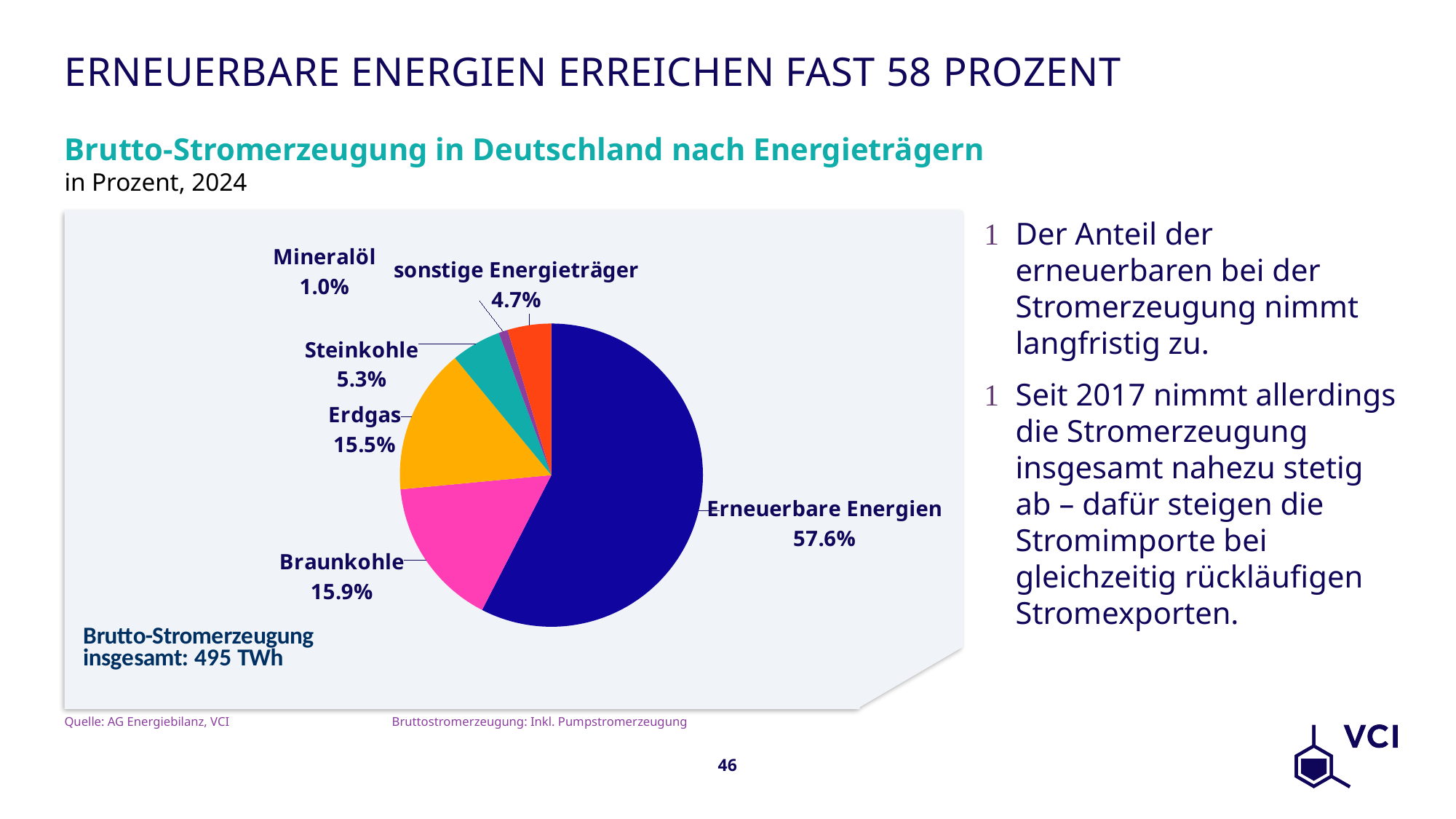
What is the difference in percentage points between Braunkohle and Erdgas? 0.4 What is the share shown for Steinkohle? 5.3% What is the share shown for sonstige Energieträger? 4.7% What share of gross electricity generation does Erneuerbare Energien have in the pie chart? 57.6% What type of chart is shown on the slide? Pie chart What is the share shown for Braunkohle? 15.9% What total gross electricity generation in TWh is stated on the chart? 495 TWh Which energy source has the smallest slice of the pie? Mineralöl How many energy source categories are shown in the pie chart? 6 What is the share shown for Erdgas? 15.5% Which has a larger share, Steinkohle or sonstige Energieträger? Steinkohle Which energy source has the largest slice of the pie? Erneuerbare Energien